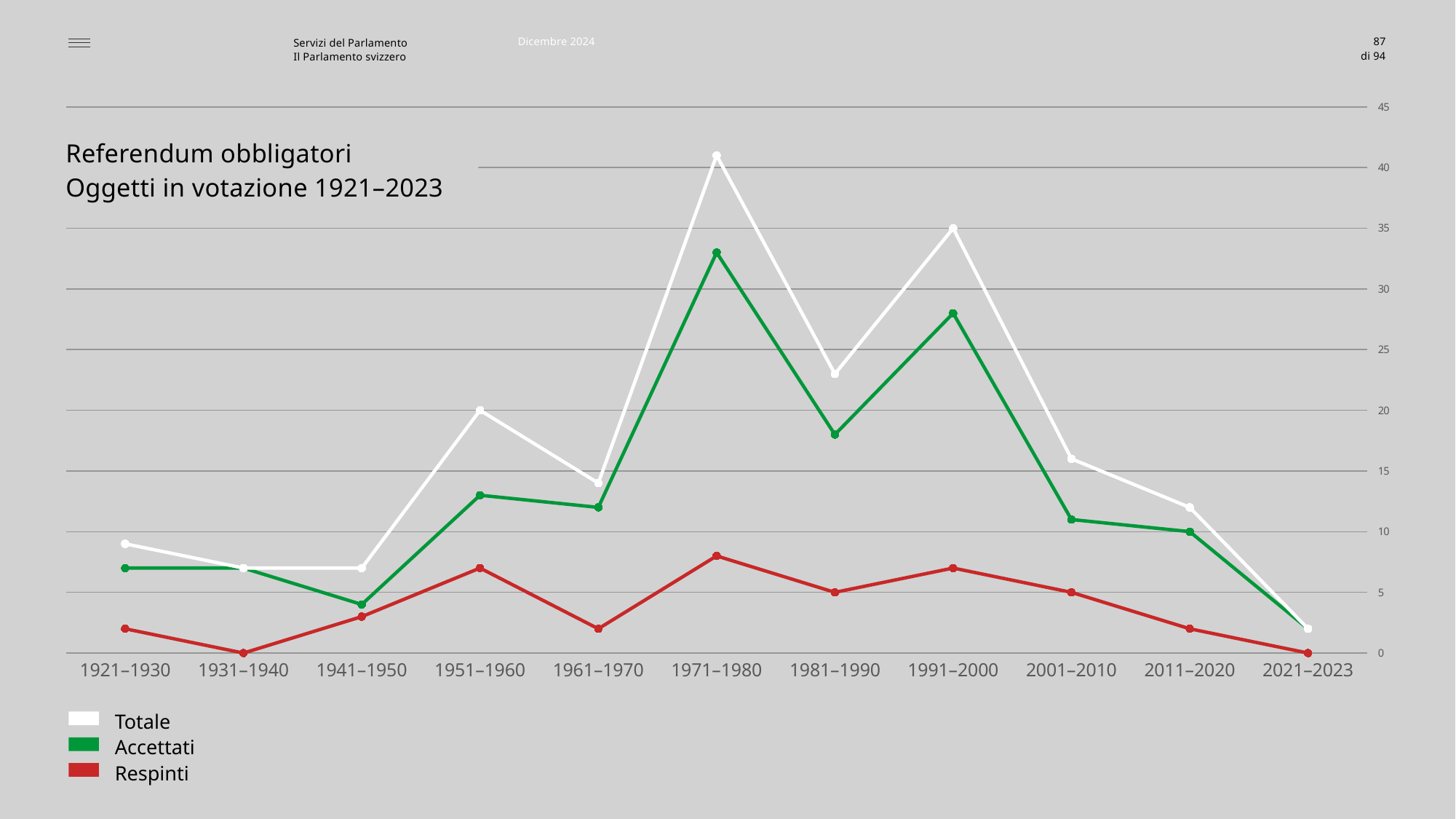
What is the value of Respinti for 1931–1940? 0 What kind of chart is shown on the slide? line chart In which period is the Totale series lowest? 2021–2023 Which is larger in 1971–1980, Accettati or Respinti? Accettati How many periods are shown along the x axis? 11 What is the value of Totale for 1991–2000? 35 What is the value of Totale for 1951–1960? 20 In which period is the Totale series highest? 1971–1980 Does the Totale series rise or fall from 1991–2000 to 2021–2023? fall How many series does the legend list? 3 Is the value of Accettati for 1941–1950 greater or less than 5? less Is the value of Totale for 1971–1980 greater or less than 40? greater